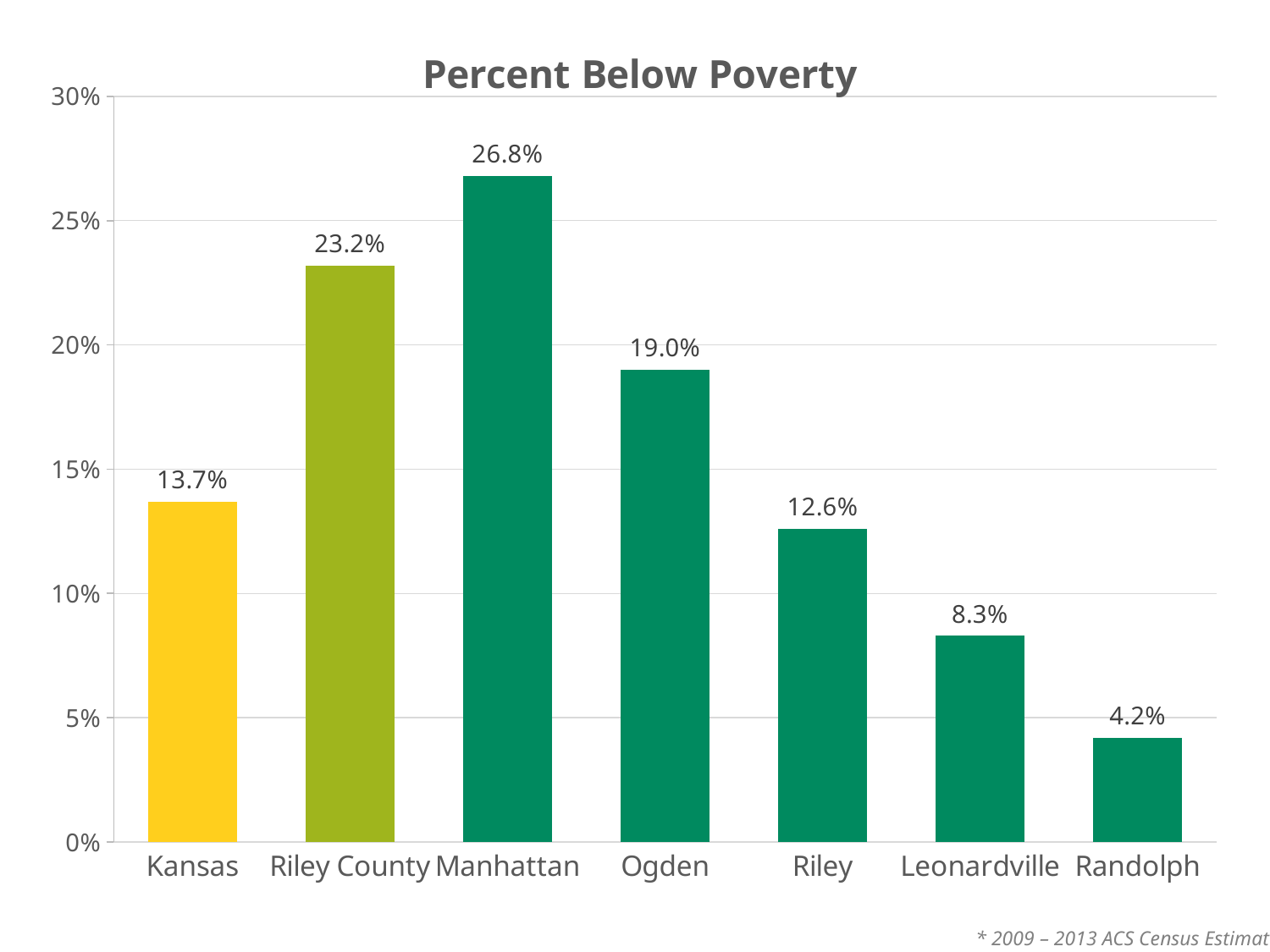
What is the difference between the percent below poverty for Riley County and Kansas? 9.5% What is the percent below poverty for Leonardville? 8.3% Which category has the lowest percent below poverty? Randolph What kind of chart is shown on the slide? Bar chart What is the title of the chart? Percent Below Poverty Which has a higher percent below poverty, Ogden or Riley? Ogden How many categories are shown on the chart? 7 What is the percent below poverty for Manhattan? 26.8% Which category has the highest percent below poverty? Manhattan What is the percent below poverty for Kansas? 13.7% Is the value for Riley County greater or less than 20%? greater What is the difference between the percent below poverty for Ogden and Riley? 6.4%